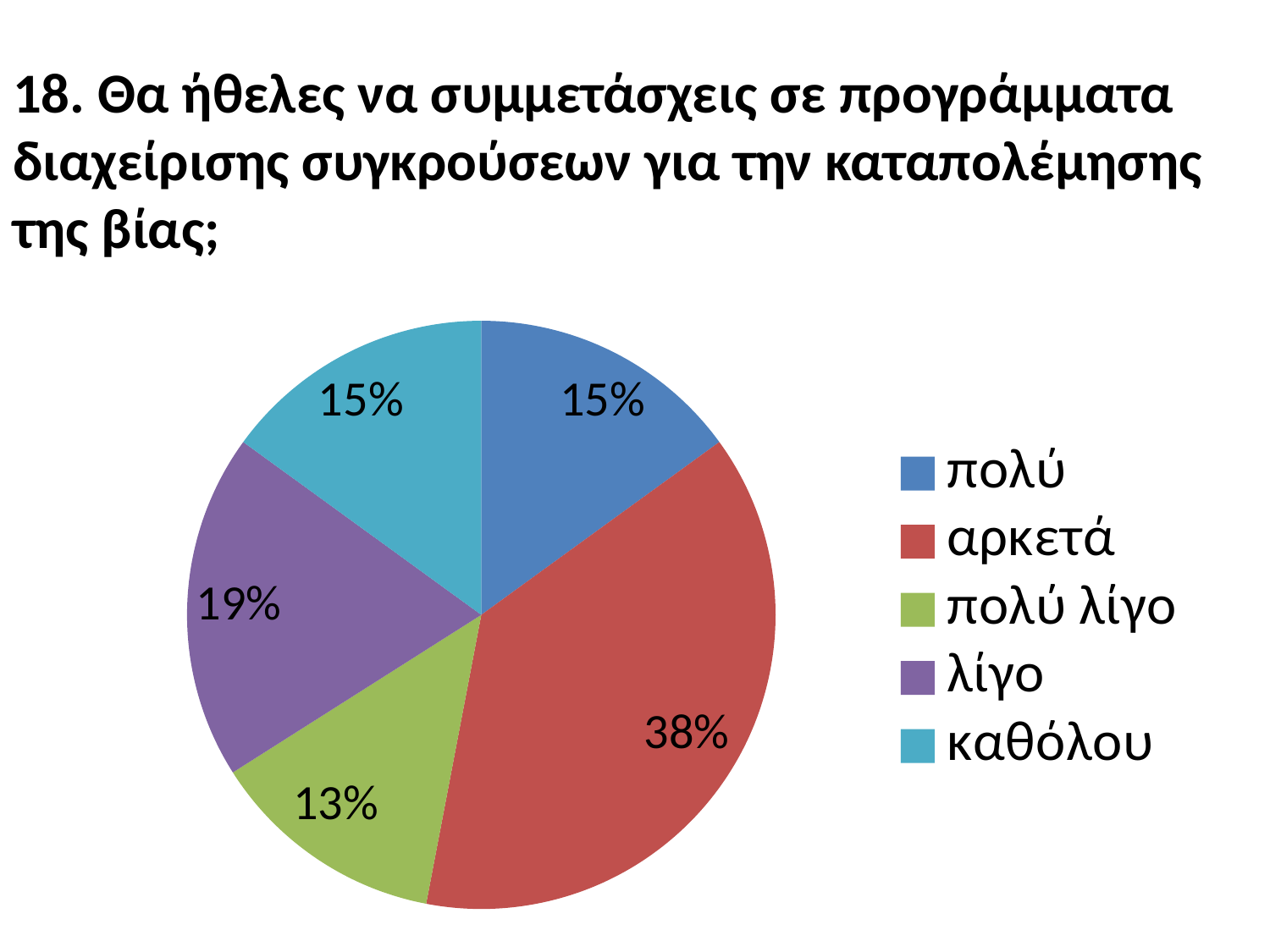
What percentage is shown for the 'καθόλου' slice? 15% What is the difference in percentage points between the 'αρκετά' slice and the 'λίγο' slice? 19 What percentage of the pie does the 'αρκετά' slice represent? 38% What percentage is shown for the 'πολύ λίγο' slice? 13% Which category has the smallest share of the pie? πολύ λίγο Which category has the largest share of the pie? αρκετά What percentage is shown for the 'λίγο' slice? 19% Which slice is larger, 'λίγο' or 'πολύ λίγο'? λίγο What colour is the 'καθόλου' slice? light blue (cyan) How many slices does the pie chart have? 5 What kind of chart is shown on the slide? pie chart How many entries does the legend list? 5